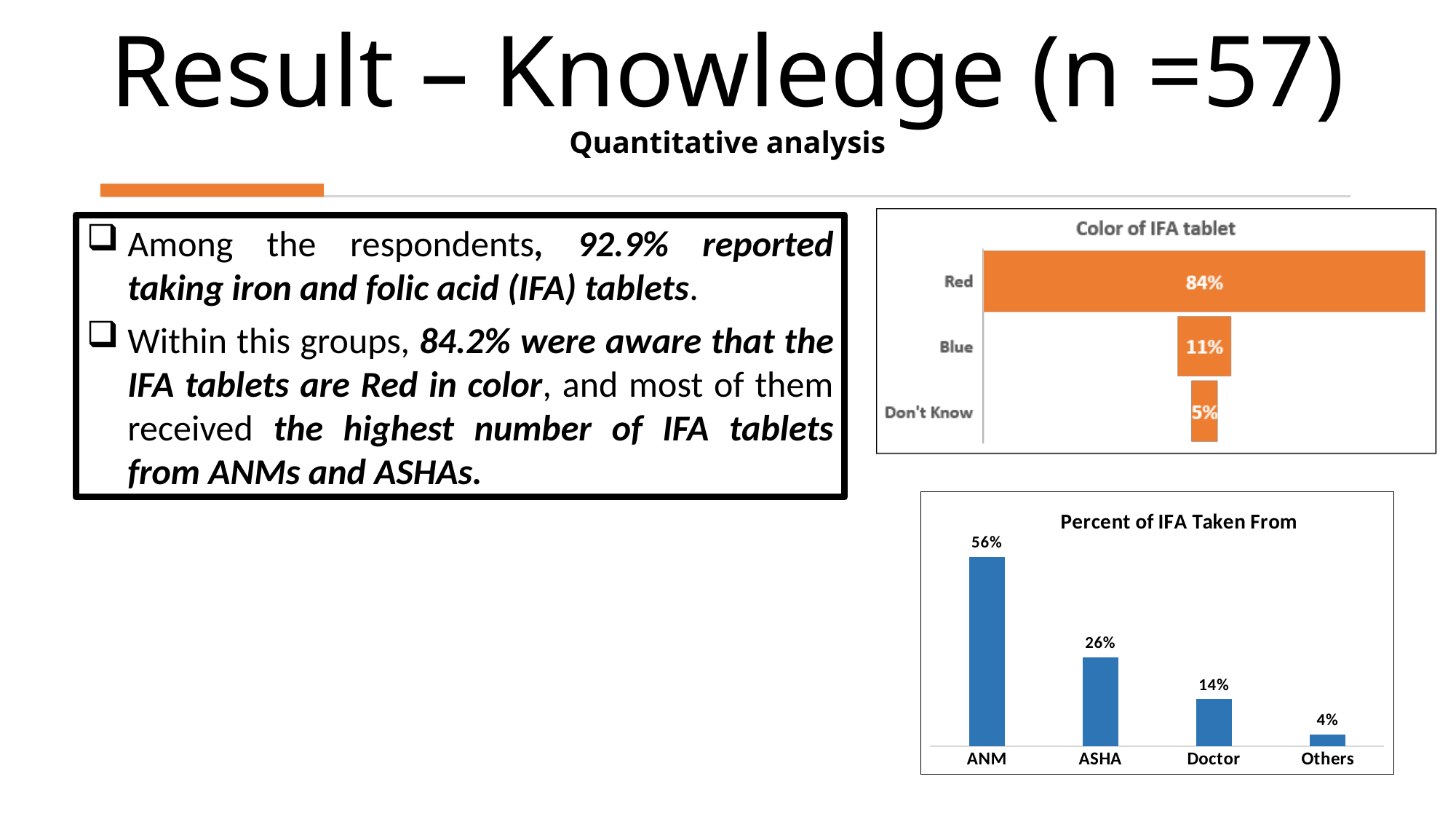
In the 'Percent of IFA Taken From' chart, which is larger, the value for Doctor or the value for Others? Doctor In the 'Color of IFA tablet' chart, what is the value for Red? 84% What kind of chart is the 'Color of IFA tablet' chart? Bar chart In the 'Color of IFA tablet' chart, how many categories are shown? 3 In the 'Color of IFA tablet' chart, what is the difference between the values for Red and Blue? 73% In the 'Percent of IFA Taken From' chart, what is the value for Doctor? 14% In the 'Percent of IFA Taken From' chart, do the values rise or fall from left to right along the x axis? Fall In the 'Percent of IFA Taken From' chart, what is the difference between the values for ANM and ASHA? 30% In the 'Percent of IFA Taken From' chart, which category has the highest value? ANM In the 'Color of IFA tablet' chart, which category has the lowest value? Don't Know In the 'Color of IFA tablet' chart, what is the value for Blue? 11% In the 'Percent of IFA Taken From' chart, what is the value for ASHA? 26%